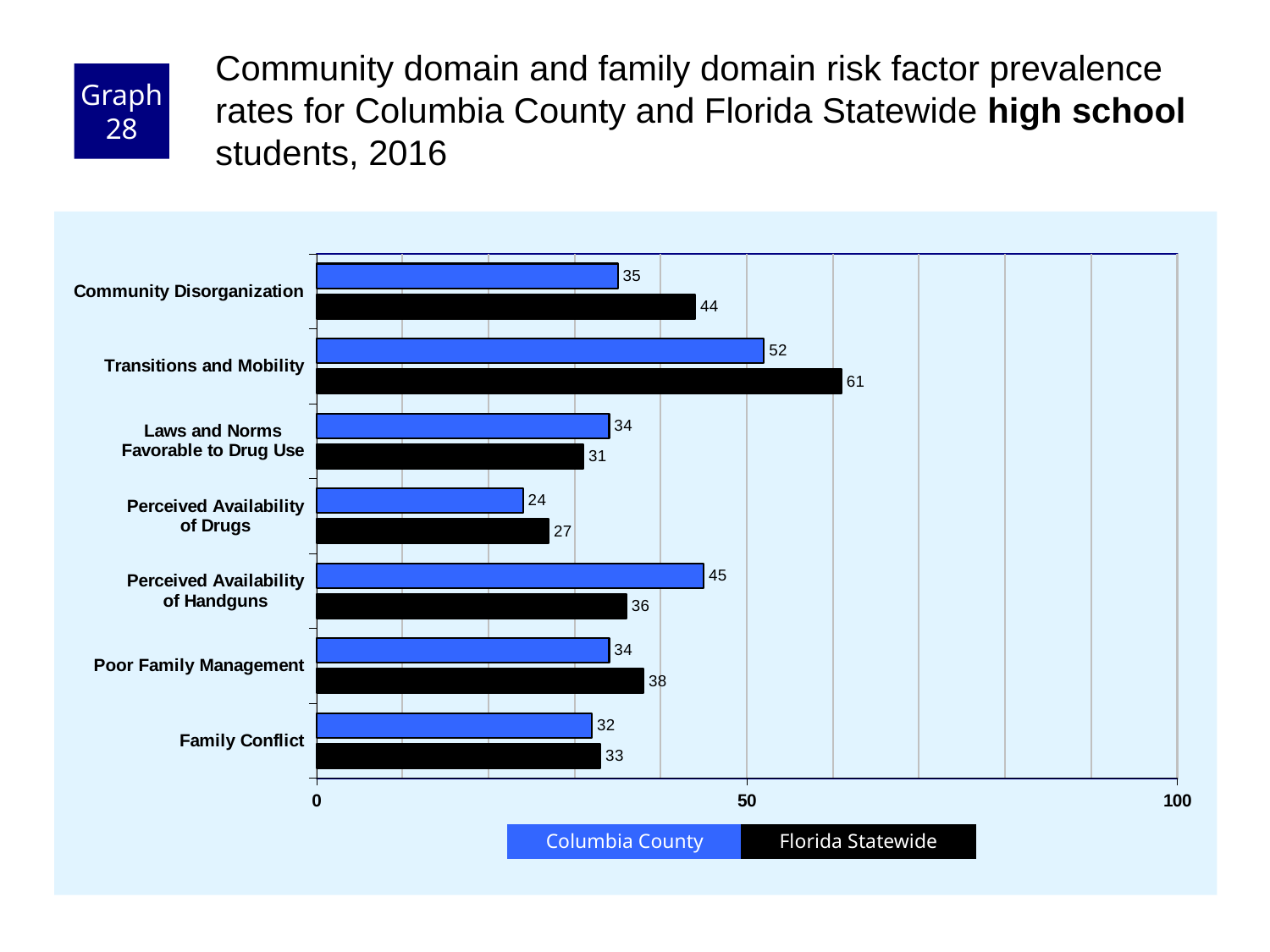
Which risk factor has the lowest Columbia County value? Perceived Availability of Drugs For Perceived Availability of Handguns, which is larger: Columbia County or Florida Statewide? Columbia County What colour are the Florida Statewide bars? Black What is the Columbia County value for Perceived Availability of Handguns? 45 How many risk factors are shown on the chart? 7 Is the Florida Statewide value for Transitions and Mobility greater or less than 50? greater What kind of chart is shown on the slide? Bar chart What is the Florida Statewide value for Perceived Availability of Drugs? 27 Which risk factor has the highest Florida Statewide value? Transitions and Mobility What is the difference between the Florida Statewide and Columbia County values for Community Disorganization? 9 How many series does the legend list? 2 What is the Columbia County value for Transitions and Mobility? 52